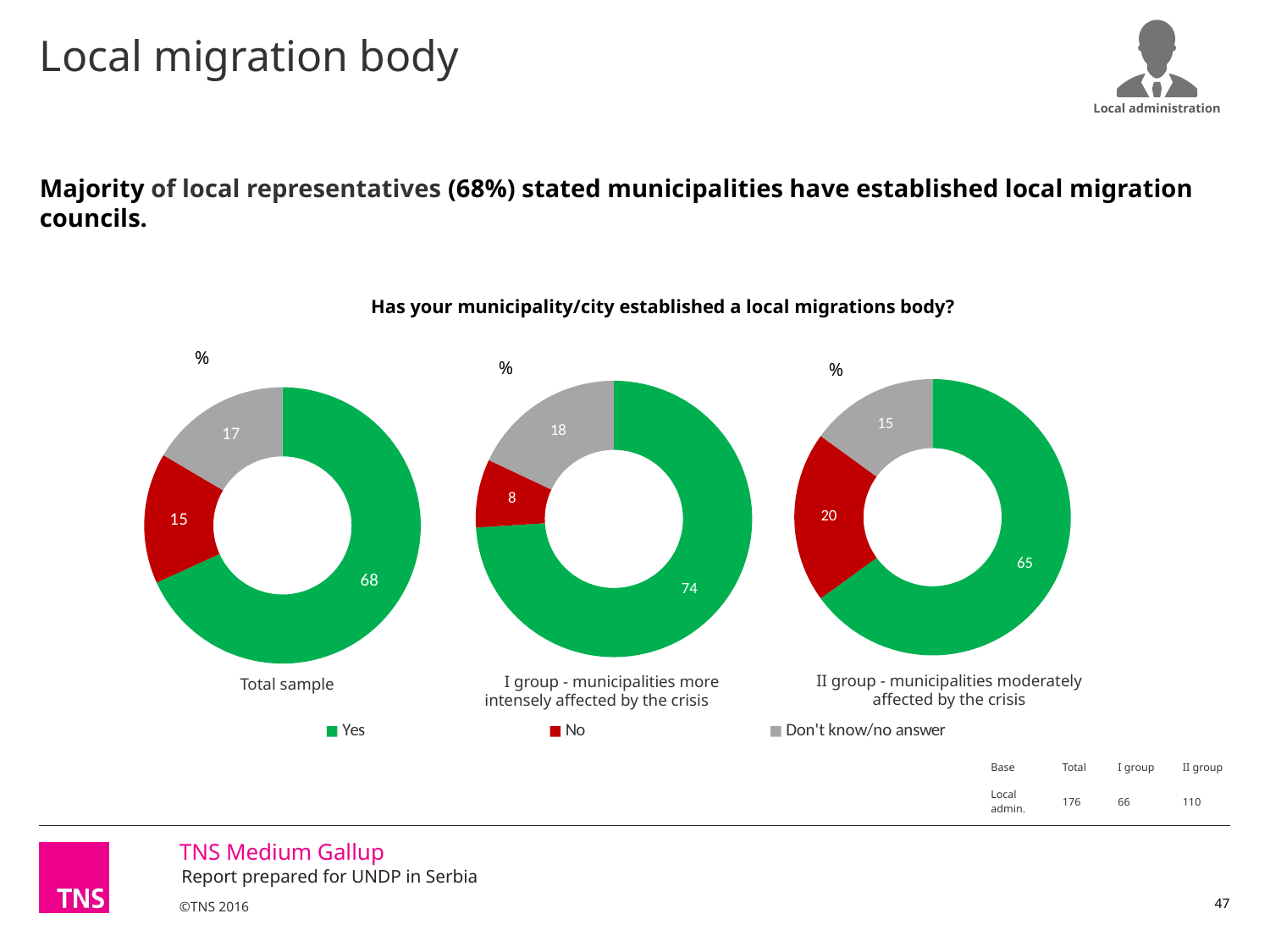
Which colour represents the No answer in the charts? Red How many entries does the legend list? 3 How many doughnut charts are shown on the slide? 3 In the Total sample chart, which is larger: the No share or the Don't know/no answer share? Don't know/no answer In the II group chart (municipalities moderately affected by the crisis), what percentage answered Don't know/no answer? 15 What type of chart is used on this slide? Doughnut chart In the Total sample chart, what percentage answered Yes? 68 In the I group chart, which answer has the smallest share? No What is the total of the three slices in the II group chart? 100 In the I group chart (municipalities more intensely affected by the crisis), what percentage answered No? 8 In the II group chart, which answer has the largest share? Yes What is the difference between the Yes share in the I group chart and the Yes share in the II group chart? 9